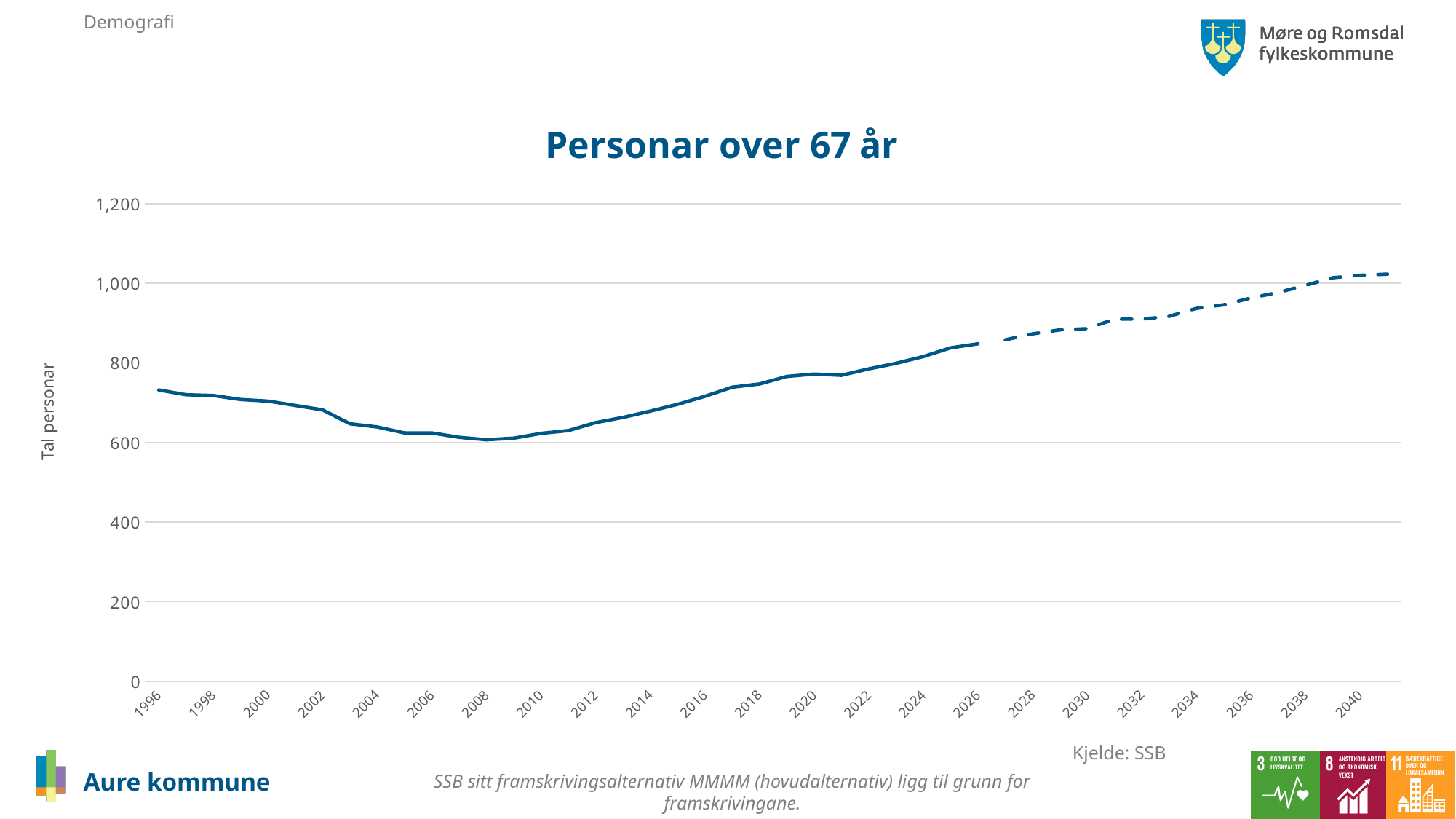
What is the title of the chart? Personar over 67 år Is the value for 1996 larger or smaller than the value for 2008? larger Is the value for 2026 greater or less than 800? greater Around which year on the x axis is the number of persons over 67 lowest? 2008 Do the values rise or fall along the x axis between 2008 and 2040? rise Is the value for 2008 greater or less than 800? less Do the values rise or fall along the x axis between 1996 and 2008? fall Is the value for 2020 greater or less than 800? less What kind of chart is shown on the slide? line chart What is the label on the vertical axis of the chart? Tal personar